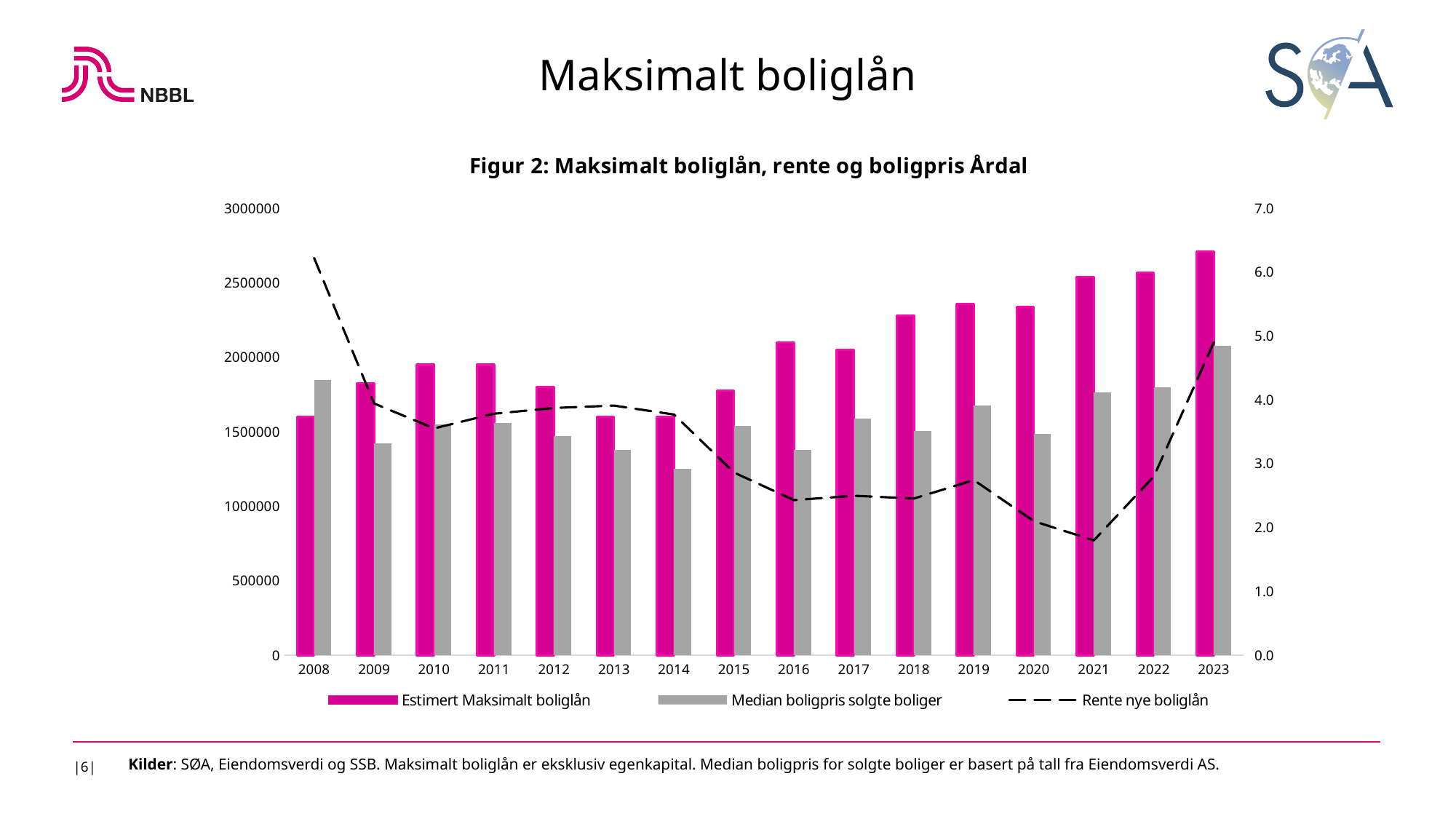
What is the title of the chart? Figur 2: Maksimalt boliglån, rente og boligpris Årdal Is the Estimert Maksimalt boliglån value for 2023 greater or less than 2500000? greater Is the Median boligpris solgte boliger value for 2014 greater or less than 1500000? less In 2008, which is larger: Estimert Maksimalt boliglån or Median boligpris solgte boliger? Median boligpris solgte boliger In which year is the Median boligpris solgte boliger bar lowest? 2014 In which year is the Rente nye boliglån line at its highest? 2008 What kind of chart is shown in Figur 2? A combined bar and line chart How many series does the legend list? 3 In which year is the Estimert Maksimalt boliglån bar highest? 2023 How many years are shown on the x axis of the chart? 16 In which year is the Rente nye boliglån line at its lowest? 2021 Is the Rente nye boliglån value for 2008 greater or less than 6.0? greater